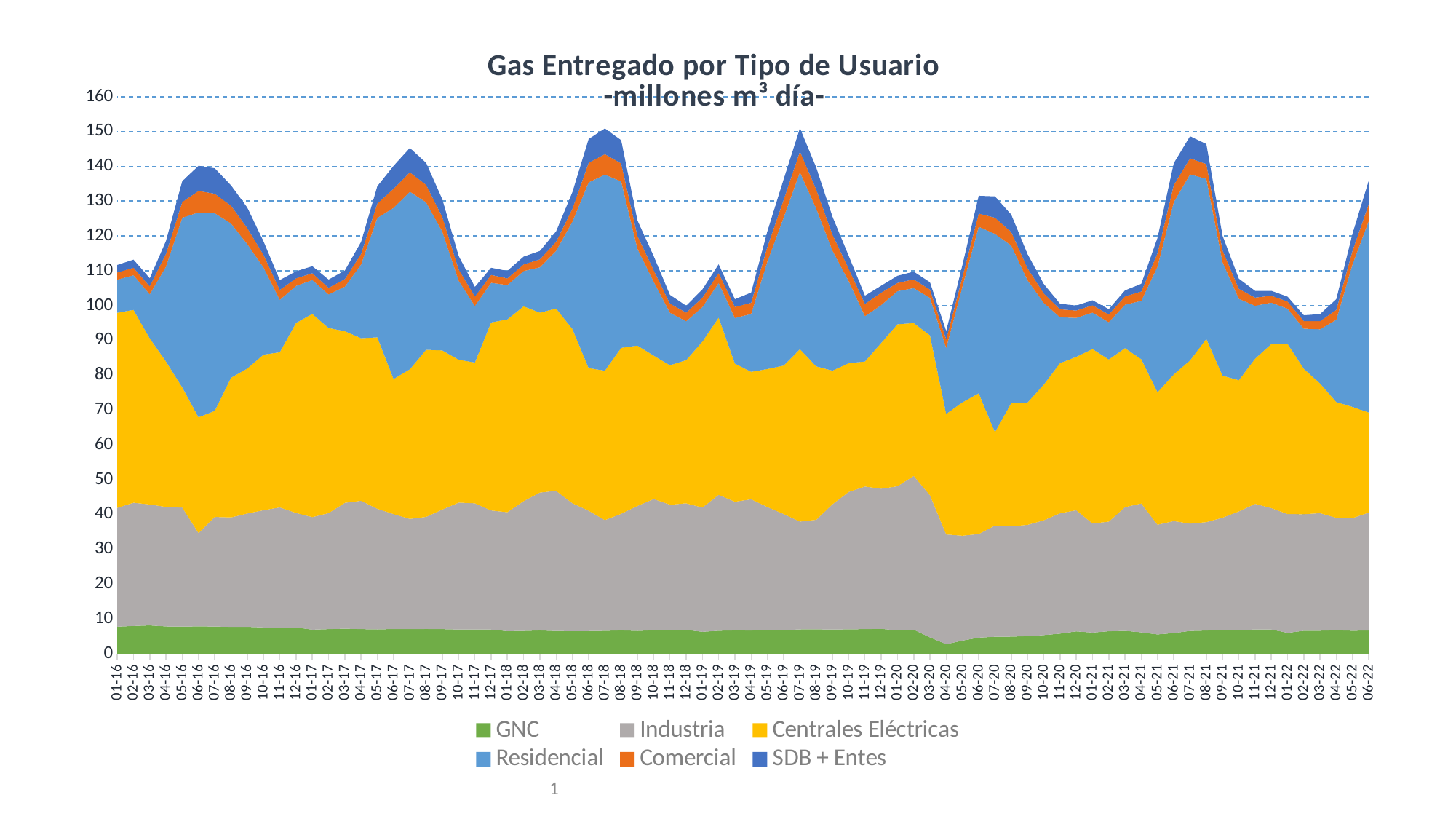
Is the total value for 07-21 greater or less than 140? greater How many monthly points are plotted along the x axis (from 01-16 to 06-22)? 78 What is the title of the chart? Gas Entregado por Tipo de Usuario -millones m³ día- What kind of chart is shown on the slide? Stacked area chart Which series is plotted at the bottom of the stack? GNC Which month has the lowest total value? 04-20 Is the total value for 04-20 greater or less than 100? less How many series does the legend list? 6 Is the GNC value for 01-16 greater or less than 10? less Which has the larger total value, 07-18 or 07-20? 07-18